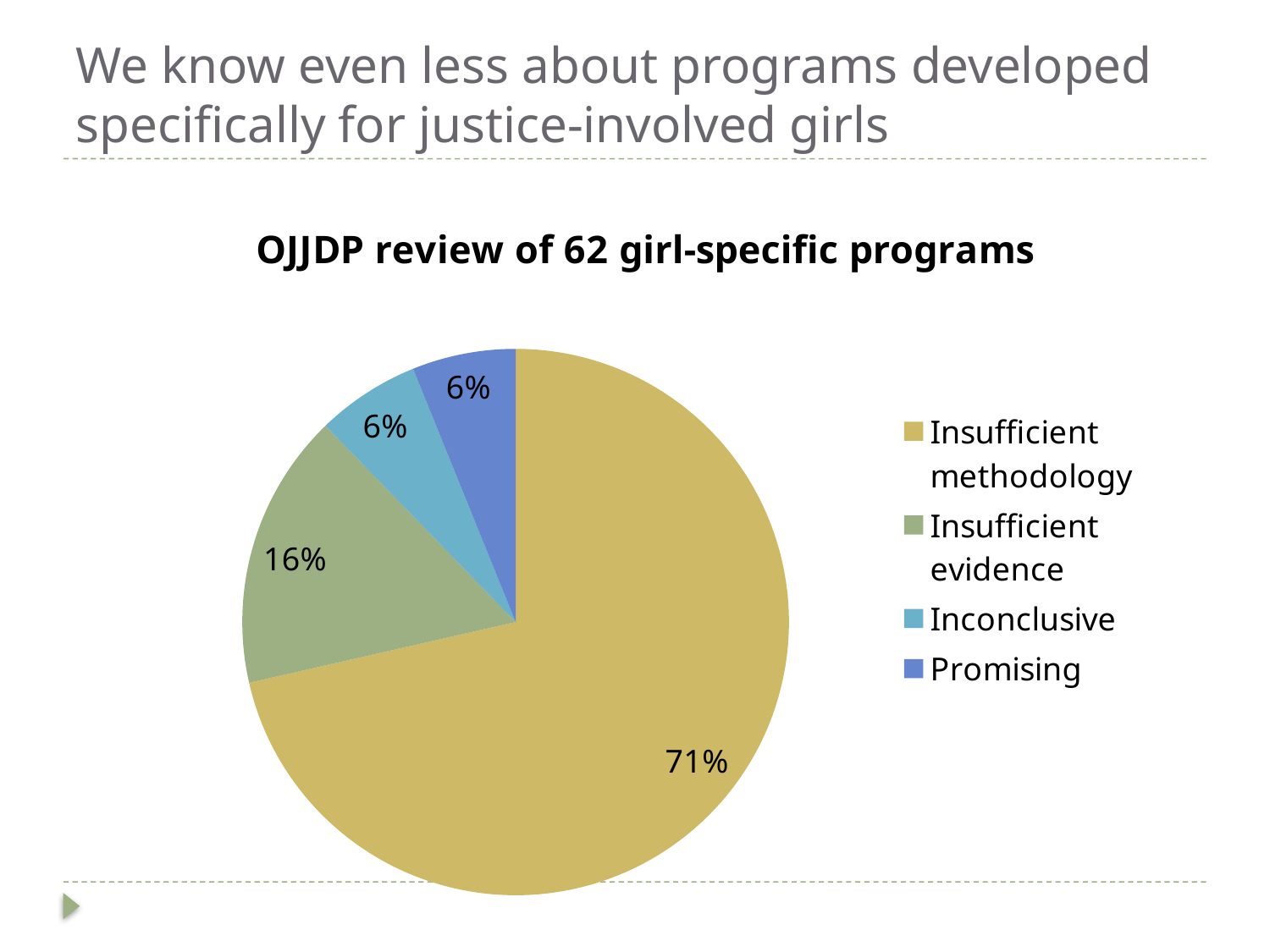
What is the difference between the Insufficient methodology share and the Insufficient evidence share? 55% What share of the pie is labelled Insufficient evidence? 16% Which category has the largest slice of the pie? Insufficient methodology What is the title of the chart? OJJDP review of 62 girl-specific programs What is the difference between the Insufficient evidence share and the Inconclusive share? 10% What share of the pie is labelled Promising? 6% What share of the pie is labelled Inconclusive? 6% What kind of chart is shown on the slide? Pie chart How many categories does the legend list? 4 What colour is the Promising slice? Blue Which is larger, the Insufficient evidence slice or the Promising slice? Insufficient evidence